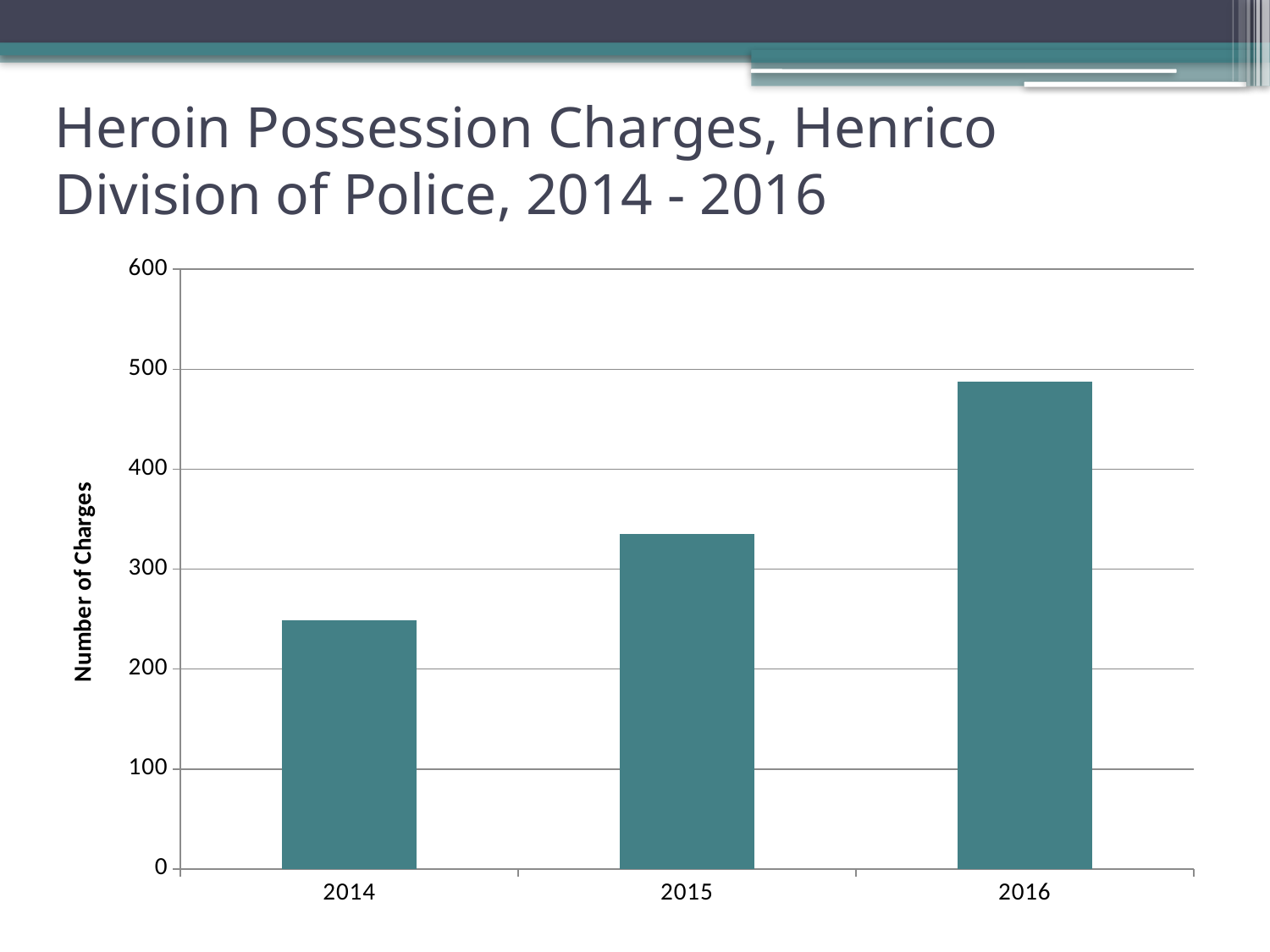
Is the value for 2016 greater or less than 500? less Is the value for 2014 greater or less than 200? greater Is the value for 2015 greater or less than 300? greater What is the label on the vertical axis of the chart? Number of Charges What kind of chart is shown on the slide? bar chart Do the number of charges rise or fall from 2014 to 2016? rise Which year has the highest number of heroin possession charges? 2016 How many years are shown on the x axis of the chart? 3 Which year has more charges, 2015 or 2016? 2016 Which year has the lowest number of heroin possession charges? 2014